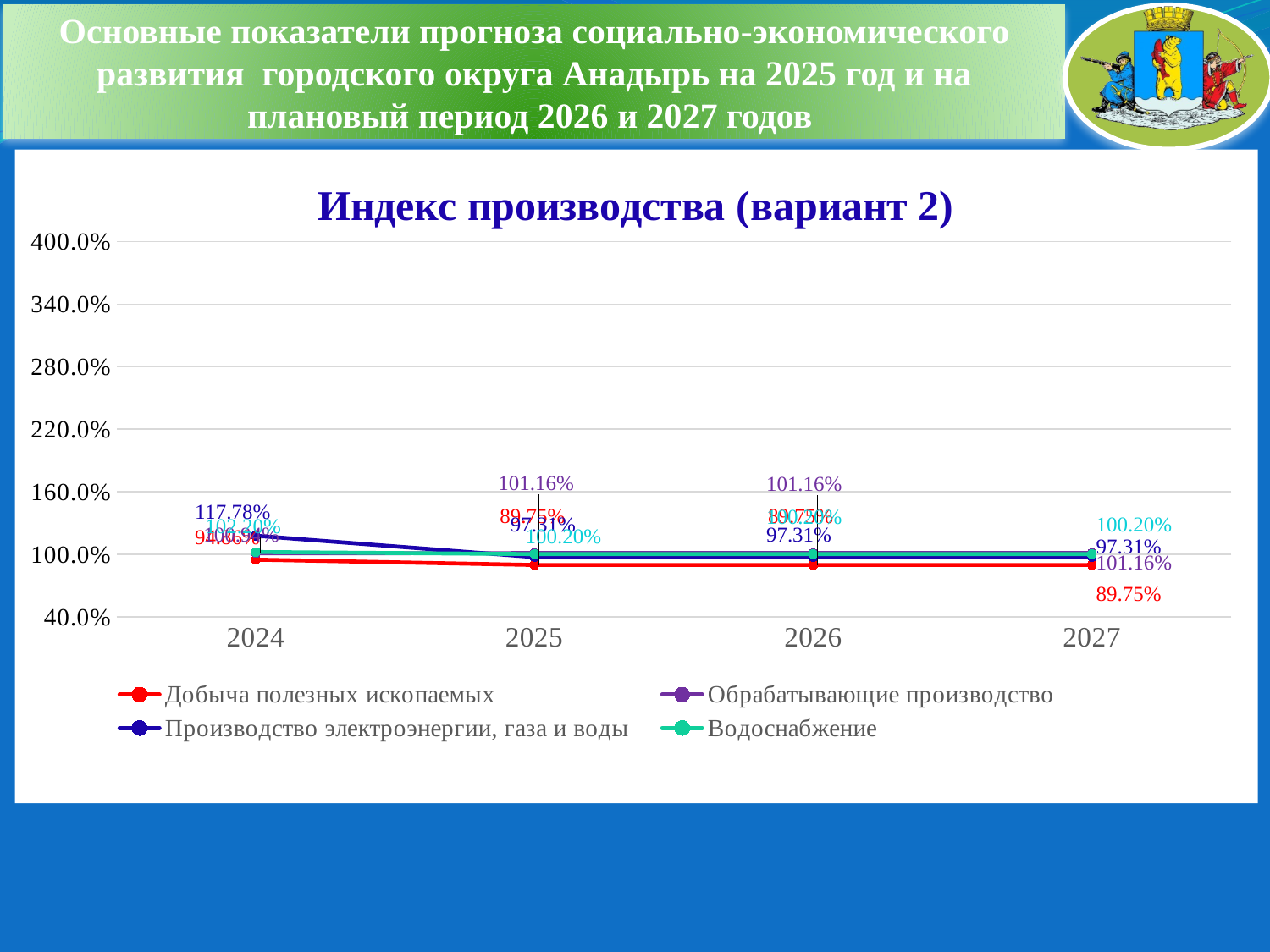
What kind of chart is shown on the slide? line chart What is the value for Добыча полезных ископаемых in 2027? 89.75% What is the difference between the 2027 values for Обрабатывающие производство and Добыча полезных ископаемых? 11.41% What is the value for Производство электроэнергии, газа и воды in 2024? 117.78% How many series does the legend list? 4 What is the value for Водоснабжение in 2027? 100.20% What is the value for Производство электроэнергии, газа и воды in 2025? 97.31% What is the value for Обрабатывающие производство in 2027? 101.16% Which series has the lowest value in 2027? Добыча полезных ископаемых How many years are shown on the x axis? 4 What is the title of the chart? Индекс производства (вариант 2) Which series has the highest value in 2024? Производство электроэнергии, газа и воды